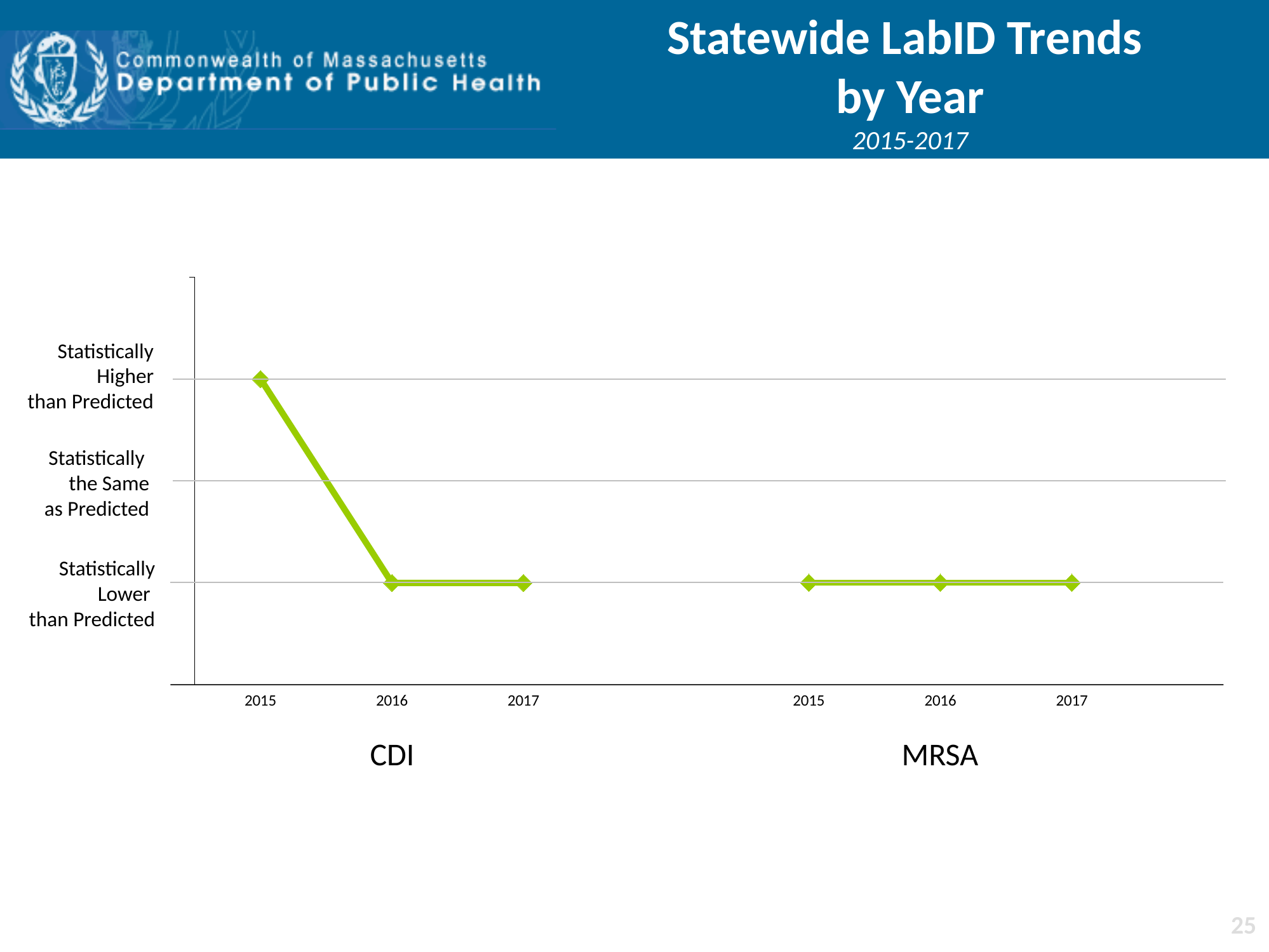
Do the MRSA values rise, fall, or stay the same from 2015 to 2017? stay the same Do the CDI values rise or fall from 2015 to 2017? fall What is the CDI value for 2015? Statistically Higher than Predicted What is the MRSA value for 2017? Statistically Lower than Predicted What is the title of the chart? Statewide LabID Trends by Year Which year has the highest CDI value? 2015 What is the CDI value for 2016? Statistically Lower than Predicted What is the MRSA value for 2015? Statistically Lower than Predicted Which is higher, the CDI value for 2015 or the MRSA value for 2015? CDI 2015 What is the CDI value for 2017? Statistically Lower than Predicted What kind of chart is shown on the slide? line chart How many data points are plotted for CDI? 3